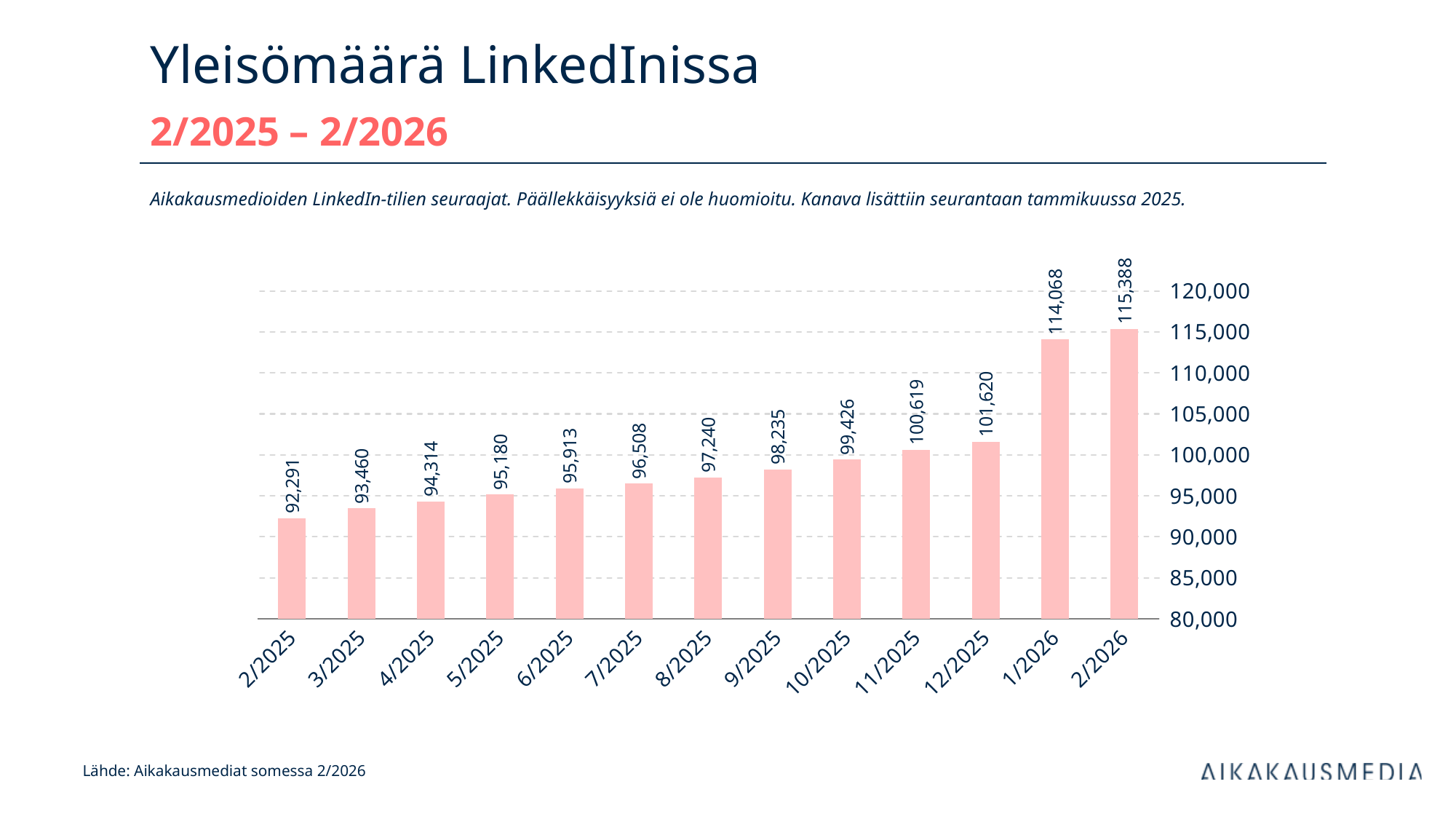
Which month has the lowest value? 2/2025 Do the values rise or fall from 2/2025 to 2/2026? Rise Is the value for 12/2025 greater or less than 100,000? greater What is the difference between the values for 2/2026 and 2/2025? 23,097 What is the difference between the values for 1/2026 and 12/2025? 12,448 What is the LinkedIn audience value for 2/2025? 92,291 What is the value shown for 1/2026? 114,068 Which is larger, the value for 11/2025 or the value for 7/2025? 11/2025 What is the value shown for 9/2025? 98,235 Which month has the highest value? 2/2026 What kind of chart is shown on the slide? Bar chart How many months are shown on the x axis? 13